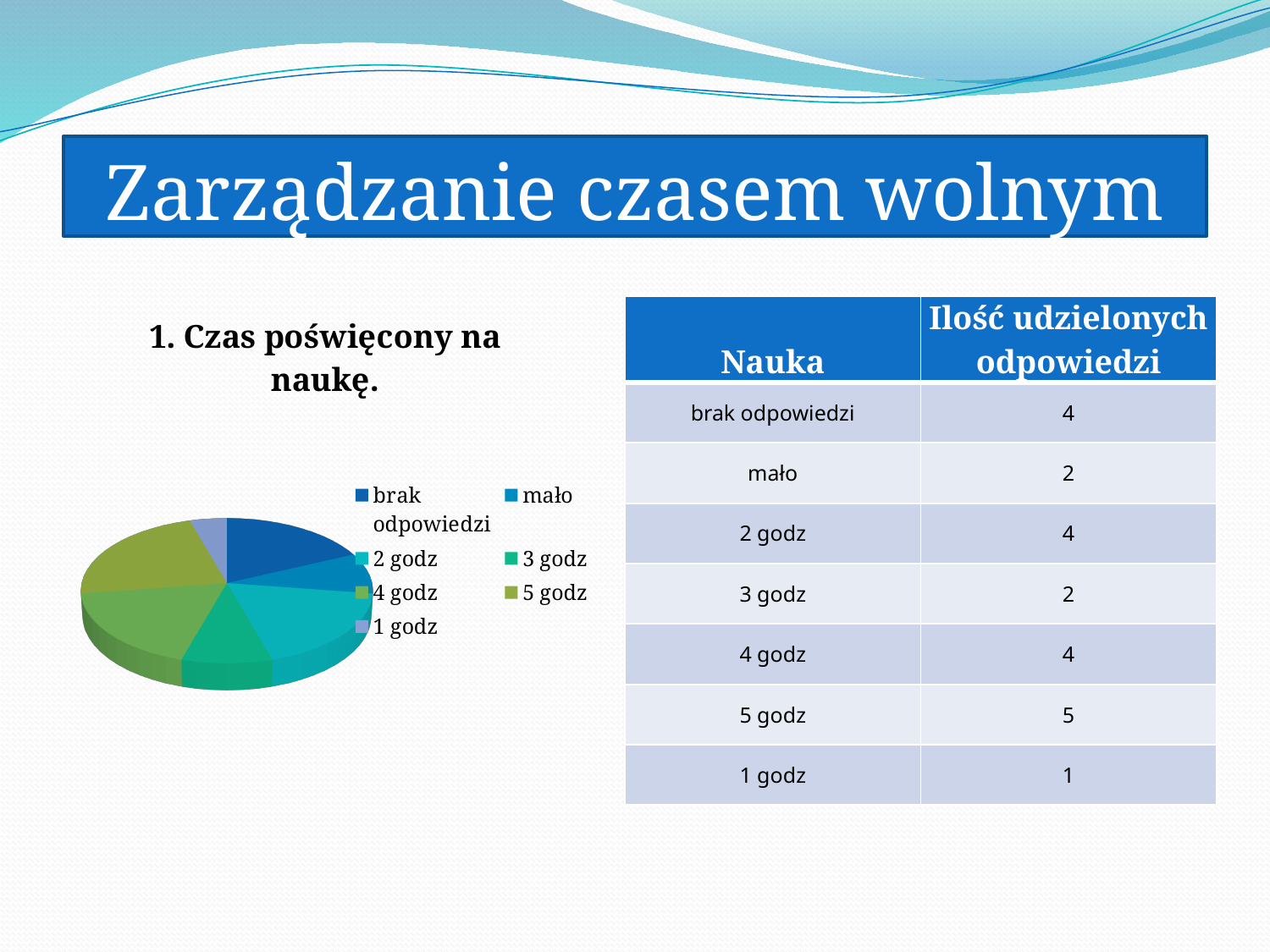
According to the table on the slide, how many responses were given for "1 godz"? 1 How many categories does the pie chart's legend list? 7 What kind of chart is shown on the slide? pie chart What is the title of the pie chart? 1. Czas poświęcony na naukę. Which legend entry of the pie chart is shown in dark blue? brak odpowiedzi According to the table on the slide, how many responses were given for "brak odpowiedzi"? 4 According to the table on the slide, how many responses were given for "5 godz"? 5 What is the total number of responses across all categories in the pie chart? 22 Which has more responses, "2 godz" or "3 godz"? 2 godz Which category has the highest number of responses in the pie chart? 5 godz Which category has the lowest number of responses in the pie chart? 1 godz What is the difference between the number of responses for "5 godz" and "mało"? 3